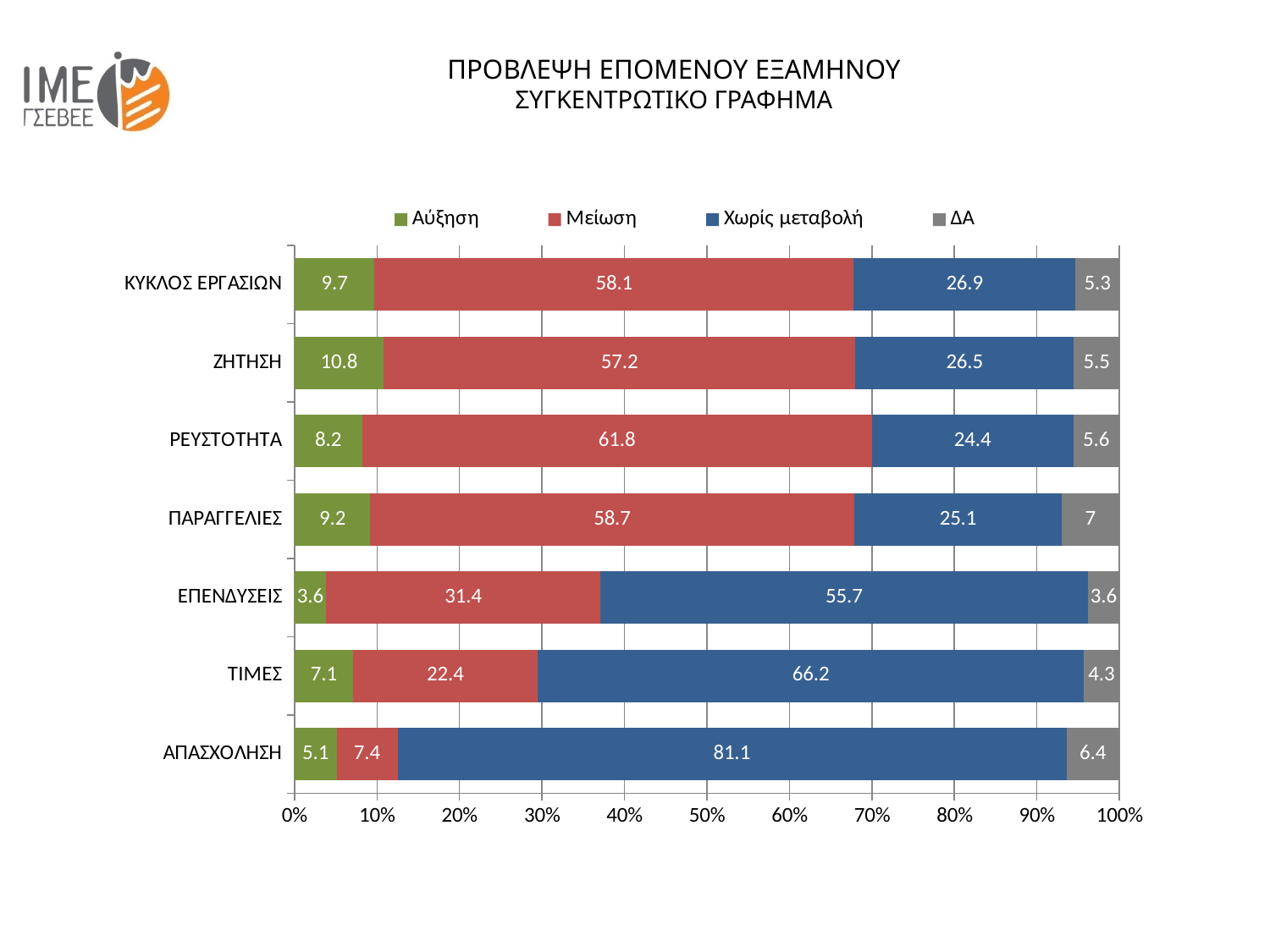
What is the Μείωση value for ΡΕΥΣΤΟΤΗΤΑ? 61.8 What is the total of the stacked bar for ΕΠΕΝΔΥΣΕΙΣ? 94.3 How many series does the legend list? 4 What is the Χωρίς μεταβολή value for ΑΠΑΣΧΟΛΗΣΗ? 81.1 What is the difference between the Μείωση values for ΚΥΚΛΟΣ ΕΡΓΑΣΙΩΝ and ΤΙΜΕΣ? 35.7 What type of chart is shown on the slide? Stacked bar chart What is the ΔΑ value for ΠΑΡΑΓΓΕΛΙΕΣ? 7 Which category has the lowest Αύξηση value? ΕΠΕΝΔΥΣΕΙΣ How many categories are plotted on the chart? 7 Which is larger: the Χωρίς μεταβολή value for ΤΙΜΕΣ or for ΕΠΕΝΔΥΣΕΙΣ? ΤΙΜΕΣ What is the Αύξηση value for ΖΗΤΗΣΗ? 10.8 Which category has the highest Χωρίς μεταβολή value? ΑΠΑΣΧΟΛΗΣΗ